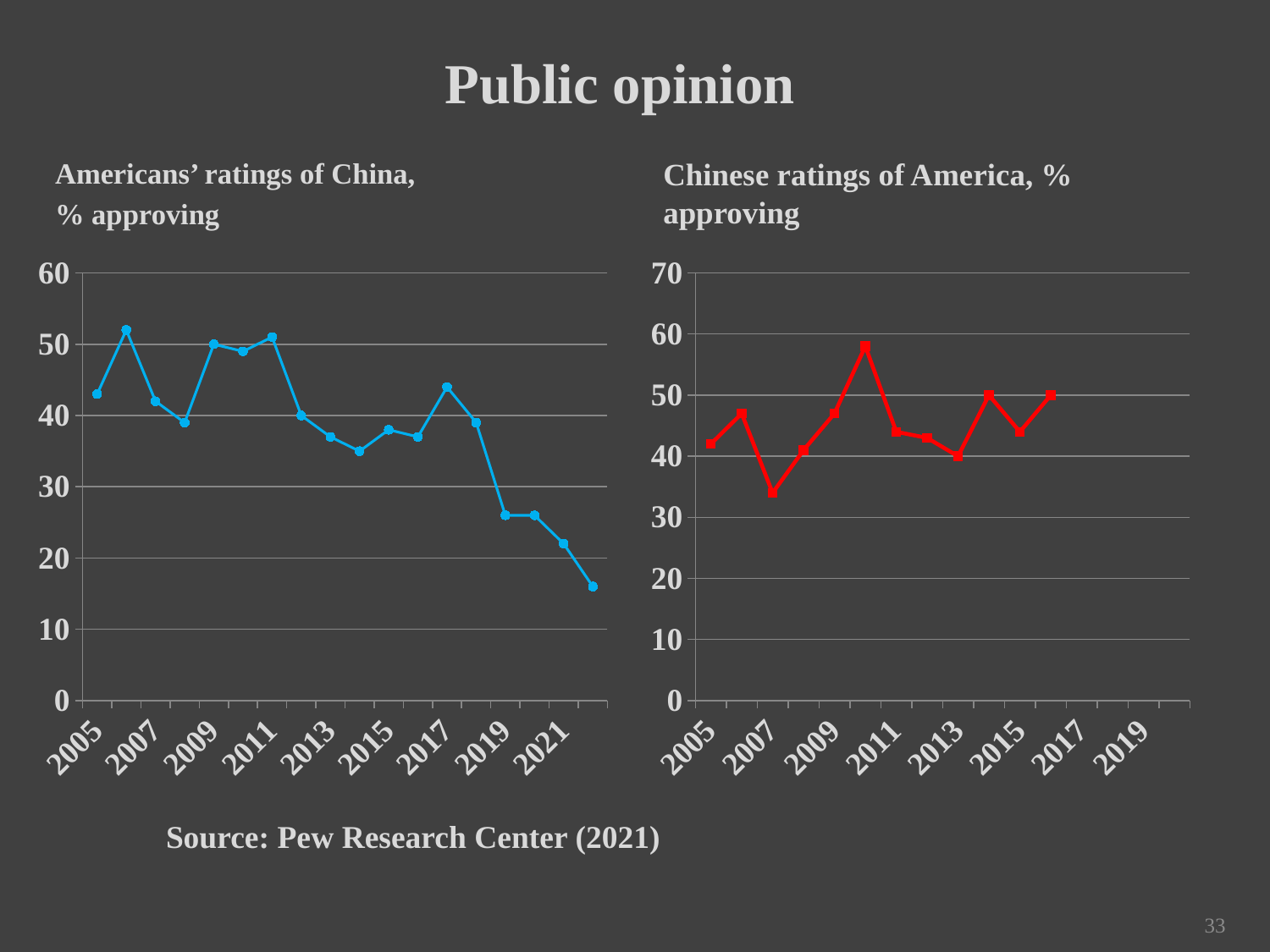
In the 'Chinese ratings of America, % approving' chart, is the value for 2007 greater or less than 40? less What colour is the line in the 'Chinese ratings of America, % approving' chart? red In the 'Chinese ratings of America, % approving' chart, which is larger, the value for 2010 or the value for 2007? 2010 In the 'Americans' ratings of China, % approving' chart, do the values overall rise or fall from 2005 to 2022? fall In the 'Chinese ratings of America, % approving' chart, which year has the lowest value? 2007 In the 'Chinese ratings of America, % approving' chart, is the value for 2010 greater or less than 50? greater In the 'Americans' ratings of China, % approving' chart, is the value for 2019 greater or less than 30? less In the 'Americans' ratings of China, % approving' chart, which year has the lowest value? 2022 In the 'Chinese ratings of America, % approving' chart, which year has the highest value? 2010 What kind of chart is the 'Americans' ratings of China, % approving' chart? line chart